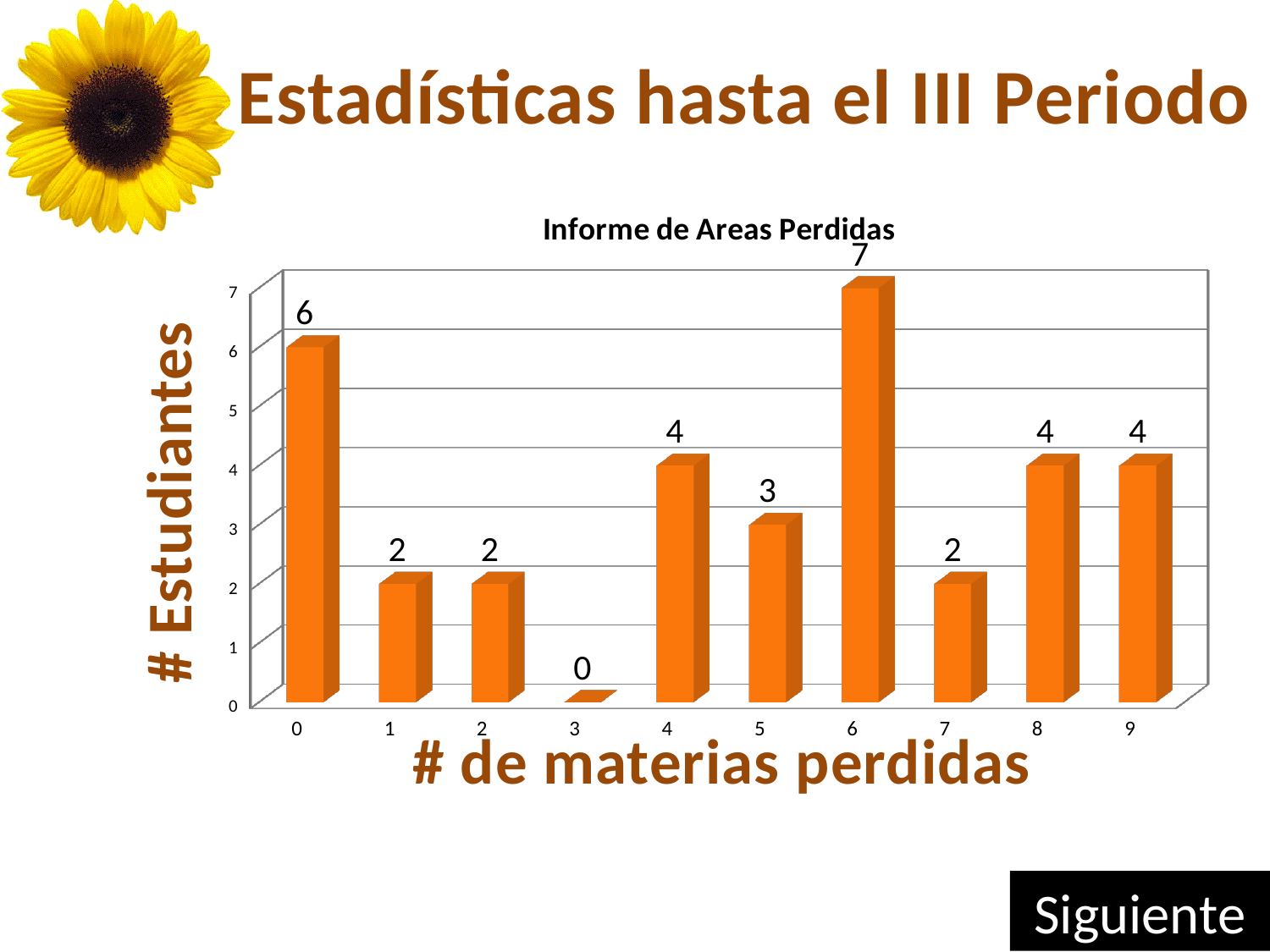
What is the value for category 3 on the x axis? 0 What is the difference between the values for category 6 and category 0? 1 What is the value for category 5 on the x axis? 3 Which category on the x axis has the lowest number of students? 3 What is the value for category 6 on the x axis? 7 What is the label of the y axis? # Estudiantes How many categories are shown on the x axis? 10 What type of chart is shown on the slide? bar chart Which is larger, the value for category 4 or the value for category 7? category 4 How many students lost 0 subjects (category 0)? 6 Which category on the x axis has the highest number of students? 6 What is the title of the chart? Informe de Areas Perdidas